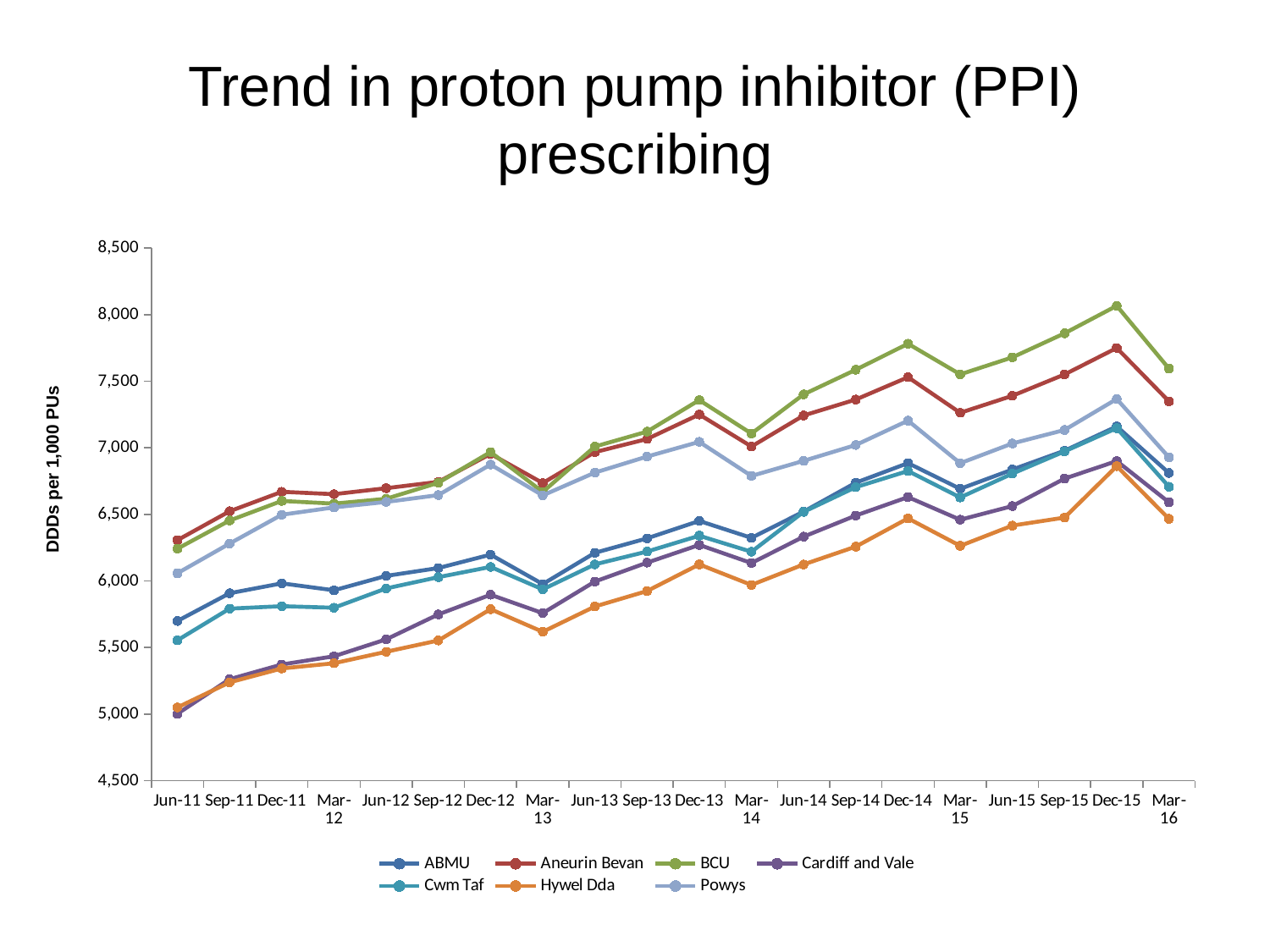
Do the values for BCU generally rise or fall from Jun-11 to Dec-15? rise Which series has the highest value at Dec-15? BCU How many series does the legend list? 7 Is the value for ABMU at Jun-11 greater or less than 5,500? greater What type of chart is shown on the slide? Line chart Which series has the lowest value at Mar-16? Hywel Dda How many time points are plotted along the x axis? 20 What is the label on the y axis? DDDs per 1,000 PUs At Jun-11, which is higher: Powys or ABMU? Powys Is the value for Cwm Taf at Mar-16 greater or less than 6,500? greater What is the title of the chart? Trend in proton pump inhibitor (PPI) prescribing Is the value for BCU at Dec-15 greater or less than 8,000? greater